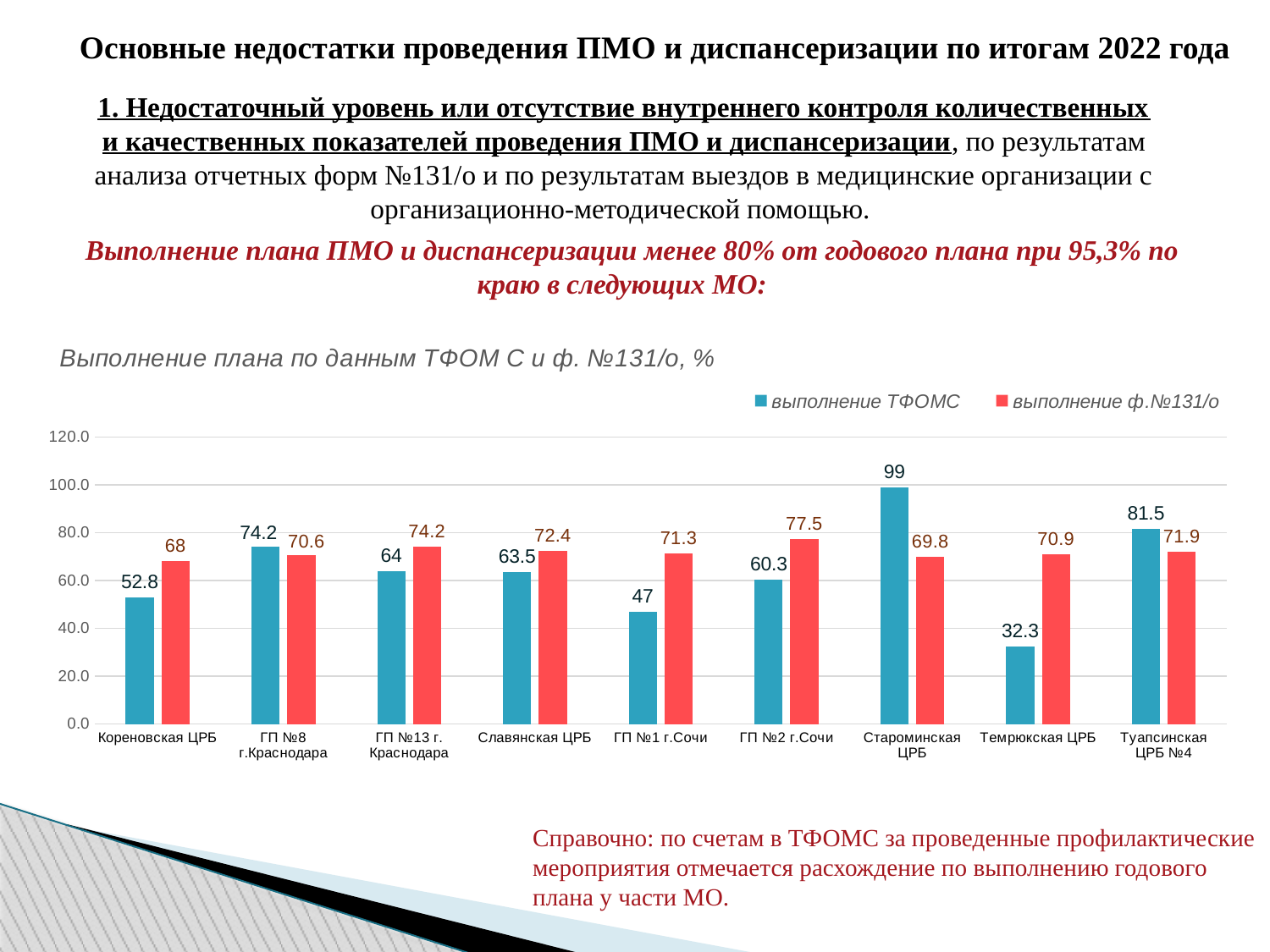
Which organisation has the lowest value for выполнение ф.№131/о? Кореновская ЦРБ For ГП №1 г.Сочи, which is larger: выполнение ТФОМС or выполнение ф.№131/о? выполнение ф.№131/о Which organisation has the highest value for выполнение ТФОМС? Староминская ЦРБ How many medical organisations (categories) are shown on the x axis? 9 What colour are the bars for the series выполнение ф.№131/о? red What type of chart is shown on the slide? bar chart What is the difference between выполнение ТФОМС and выполнение ф.№131/о for Староминская ЦРБ? 29.2 Is the value of выполнение ТФОМС for Туапсинская ЦРБ №4 greater or less than 80? greater What is the value of выполнение ф.№131/о for ГП №2 г.Сочи? 77.5 How many series does the legend list? 2 What is the value of выполнение ТФОМС for Темрюкская ЦРБ? 32.3 Which organisation has the lowest value for выполнение ТФОМС? Темрюкская ЦРБ